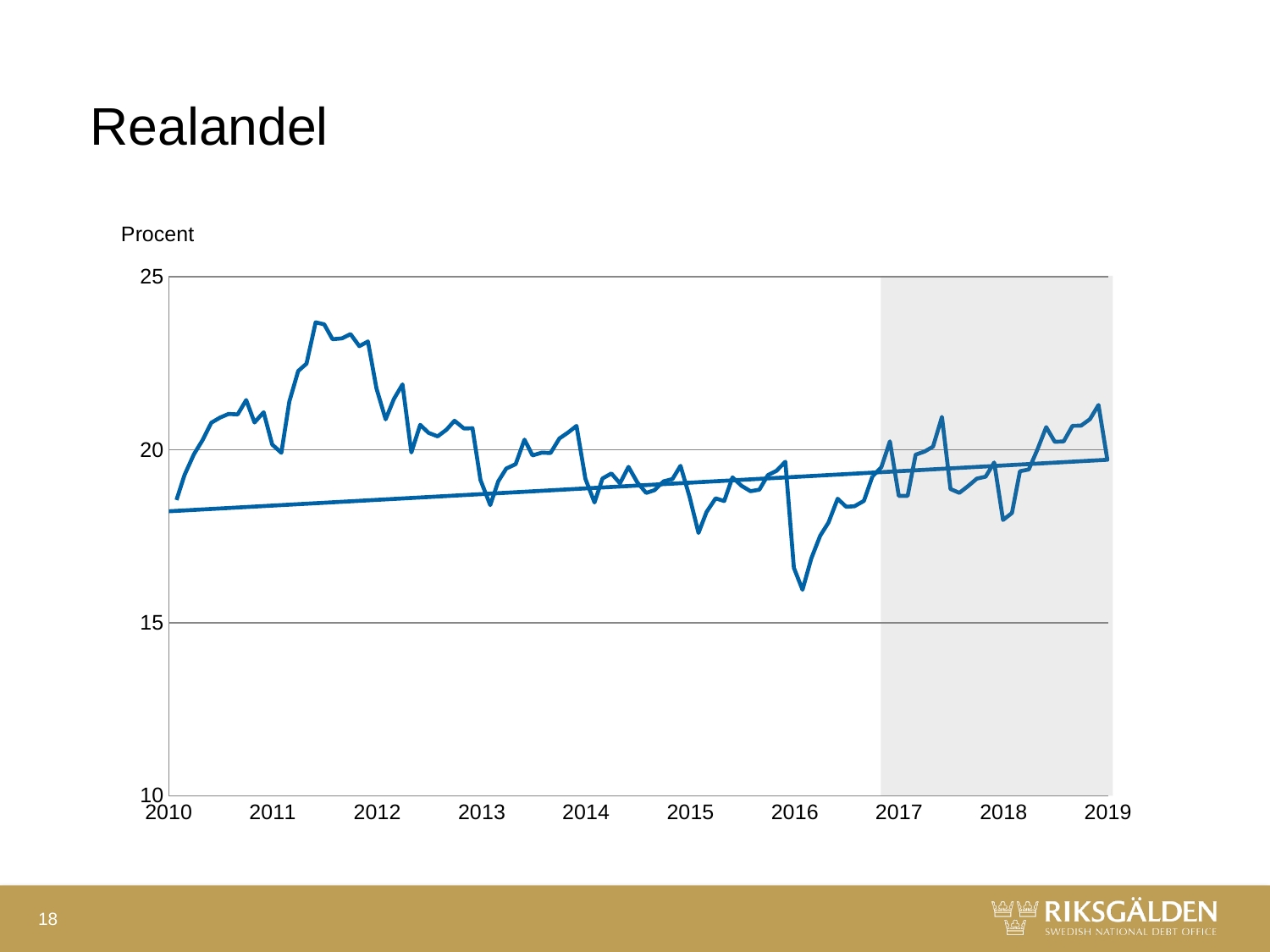
Is the lowest value of the jagged line in early 2016 greater or less than 15? greater In which year does the jagged line reach its lowest point? 2016 Is the peak value of the jagged line in 2011 greater or less than 20? greater Is the peak value of the jagged line in 2011 greater or less than 25? less How many year labels are shown on the horizontal axis? 10 What is the highest value shown on the vertical axis? 25 What is the title of the chart on the slide? Realandel What kind of chart is shown on the slide? line chart What unit label is shown above the vertical axis of the chart? Procent In which year does the jagged line reach its highest point? 2011 Does the straight trend line rise or fall from 2010 to 2019? rises